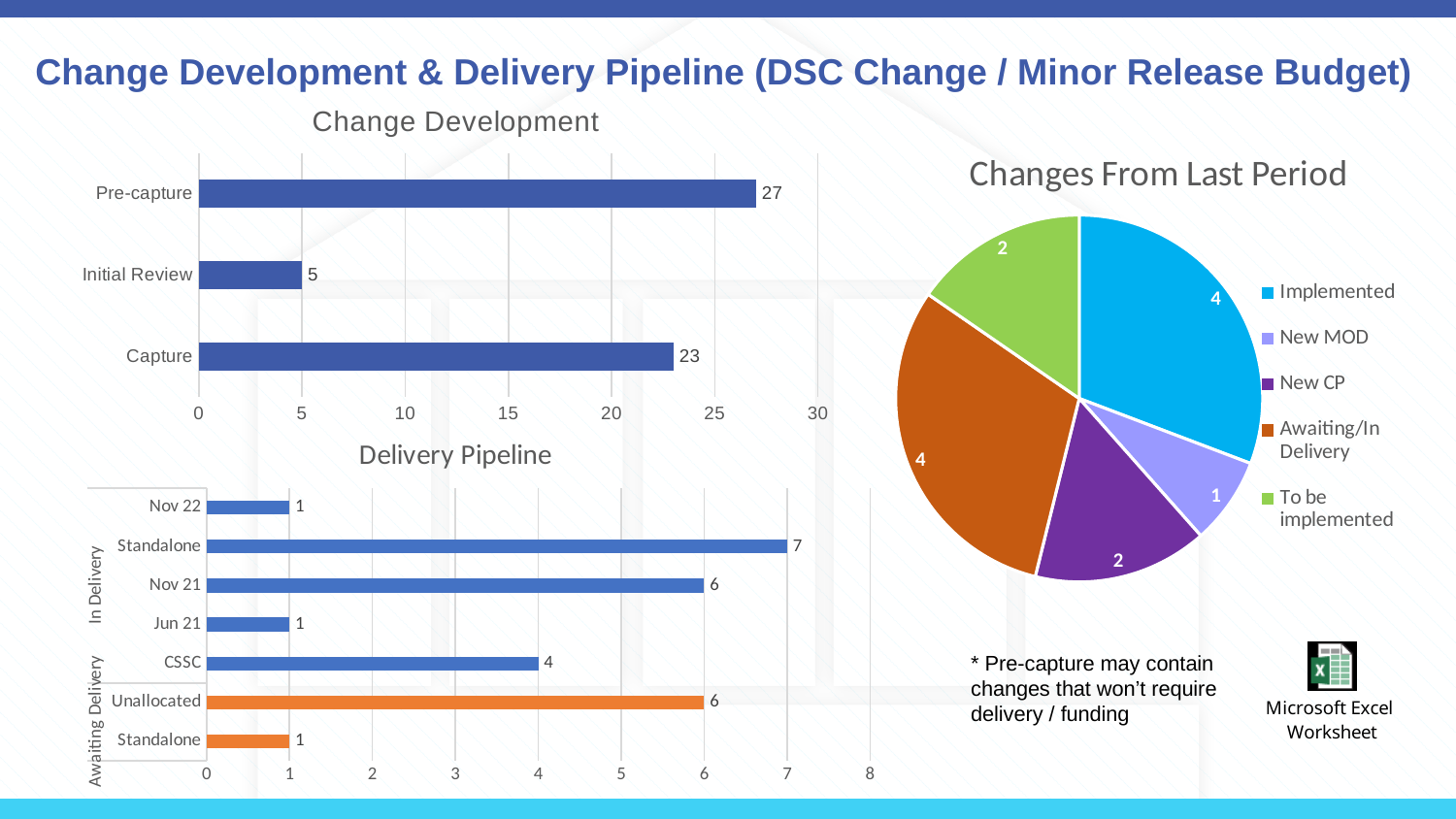
What type of chart is the Change Development chart? Bar chart In the Change Development chart, how many categories are shown? 3 In the Delivery Pipeline chart, how many bars are shown? 7 In the Delivery Pipeline chart, what is the value for Nov 21? 6 In the Delivery Pipeline chart, which is larger: CSSC or Unallocated? Unallocated In the Changes From Last Period pie chart, what is the value for New CP? 2 In the Delivery Pipeline chart, which category has the highest value? Standalone (In Delivery) In the Change Development chart, what is the value for Pre-capture? 27 In the Changes From Last Period pie chart, what is the total of all slices? 13 In the Change Development chart, which category has the lowest value? Initial Review In the Changes From Last Period pie chart, how many entries does the legend list? 5 In the Change Development chart, what is the difference between Pre-capture and Capture? 4